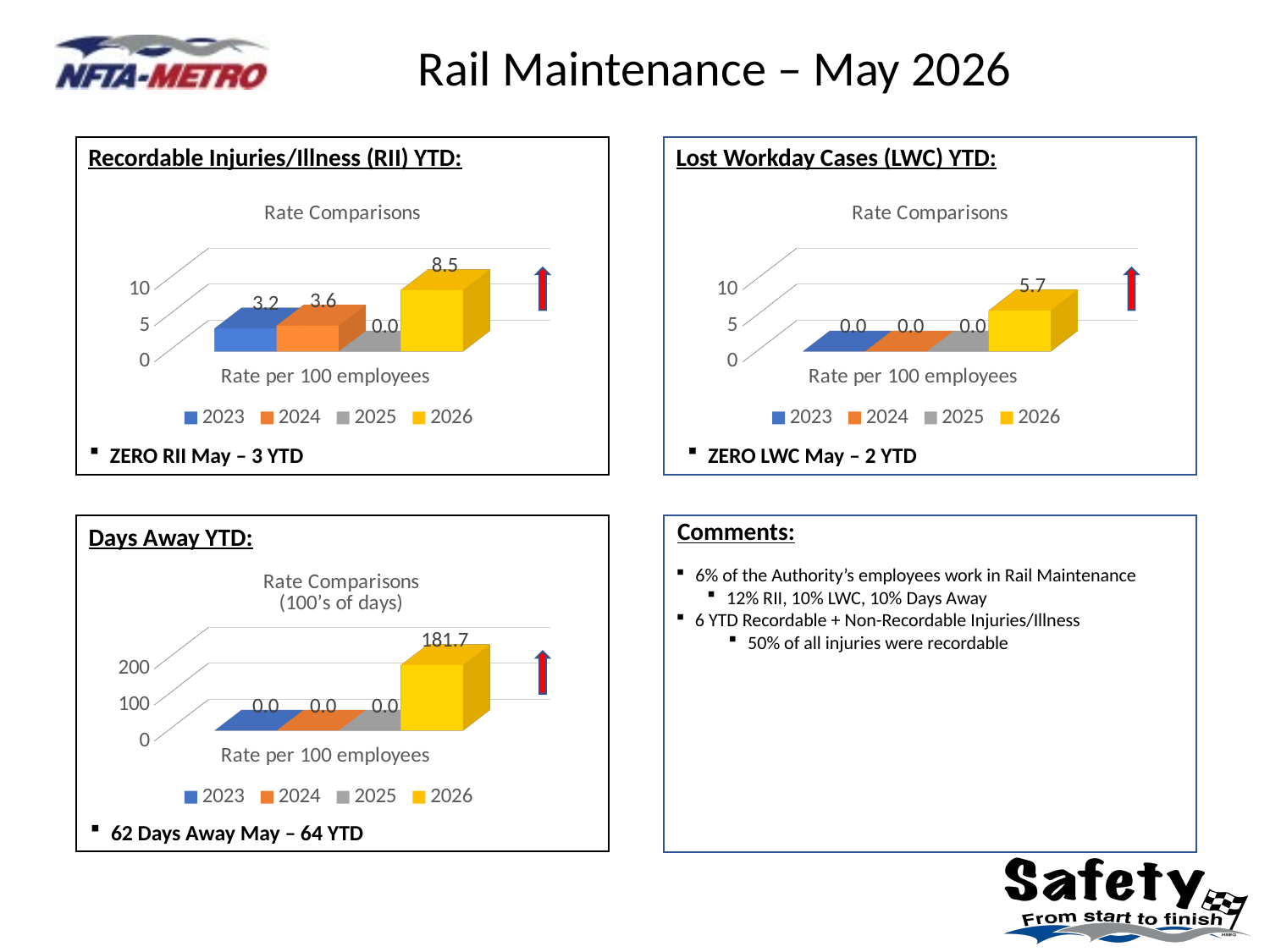
In the Days Away YTD chart, is the value for 2026 greater or less than 100? greater In the Recordable Injuries/Illness (RII) YTD chart, which is larger, the value for 2023 or the value for 2024? 2024 In the Lost Workday Cases (LWC) YTD chart, what is the value for 2026? 5.7 In the Recordable Injuries/Illness (RII) YTD chart, what is the value for 2026? 8.5 In the Lost Workday Cases (LWC) YTD chart, what is the value for 2024? 0.0 In the Recordable Injuries/Illness (RII) YTD chart, what is the value for 2024? 3.6 In the Recordable Injuries/Illness (RII) YTD chart, what is the difference between the 2026 and 2023 values? 5.3 In the Days Away YTD chart, what is the value for 2026? 181.7 What kind of chart is the Lost Workday Cases (LWC) YTD chart? Bar chart In the Lost Workday Cases (LWC) YTD chart, which year has the highest value? 2026 In the Recordable Injuries/Illness (RII) YTD chart, which year has the lowest value? 2025 How many series does the legend of the Days Away YTD chart list? 4